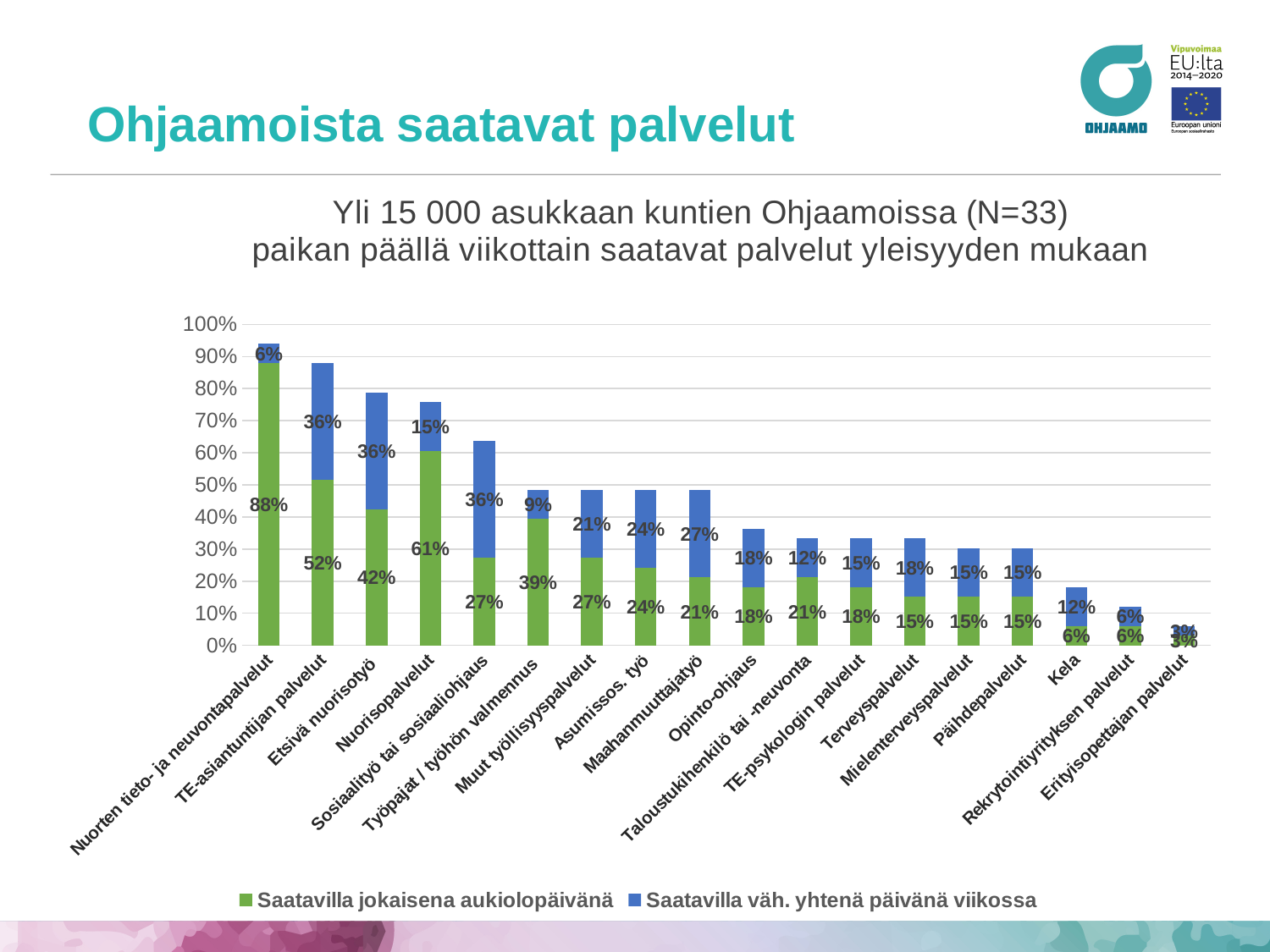
Which is larger for Kela: 'Saatavilla jokaisena aukiolopäivänä' or 'Saatavilla väh. yhtenä päivänä viikossa'? Saatavilla väh. yhtenä päivänä viikossa How many service categories are shown on the x axis? 18 Which category has the lowest total stacked bar? Erityisopettajan palvelut What is the total of the stacked bar for TE-asiantuntijan palvelut? 88% Which category has the highest value for 'Saatavilla jokaisena aukiolopäivänä'? Nuorten tieto- ja neuvontapalvelut How many series does the legend list? 2 What is the difference between the 'Saatavilla jokaisena aukiolopäivänä' values for Nuorisopalvelut and Etsivä nuorisotyö? 19% What kind of chart is shown on the slide? Stacked bar chart What is the value of 'Saatavilla jokaisena aukiolopäivänä' for Nuorten tieto- ja neuvontapalvelut? 88% Which colour represents 'Saatavilla väh. yhtenä päivänä viikossa' in the chart? Blue What is the value of 'Saatavilla jokaisena aukiolopäivänä' for Nuorisopalvelut? 61% What is the value of 'Saatavilla väh. yhtenä päivänä viikossa' for Sosiaalityö tai sosiaaliohjaus? 36%